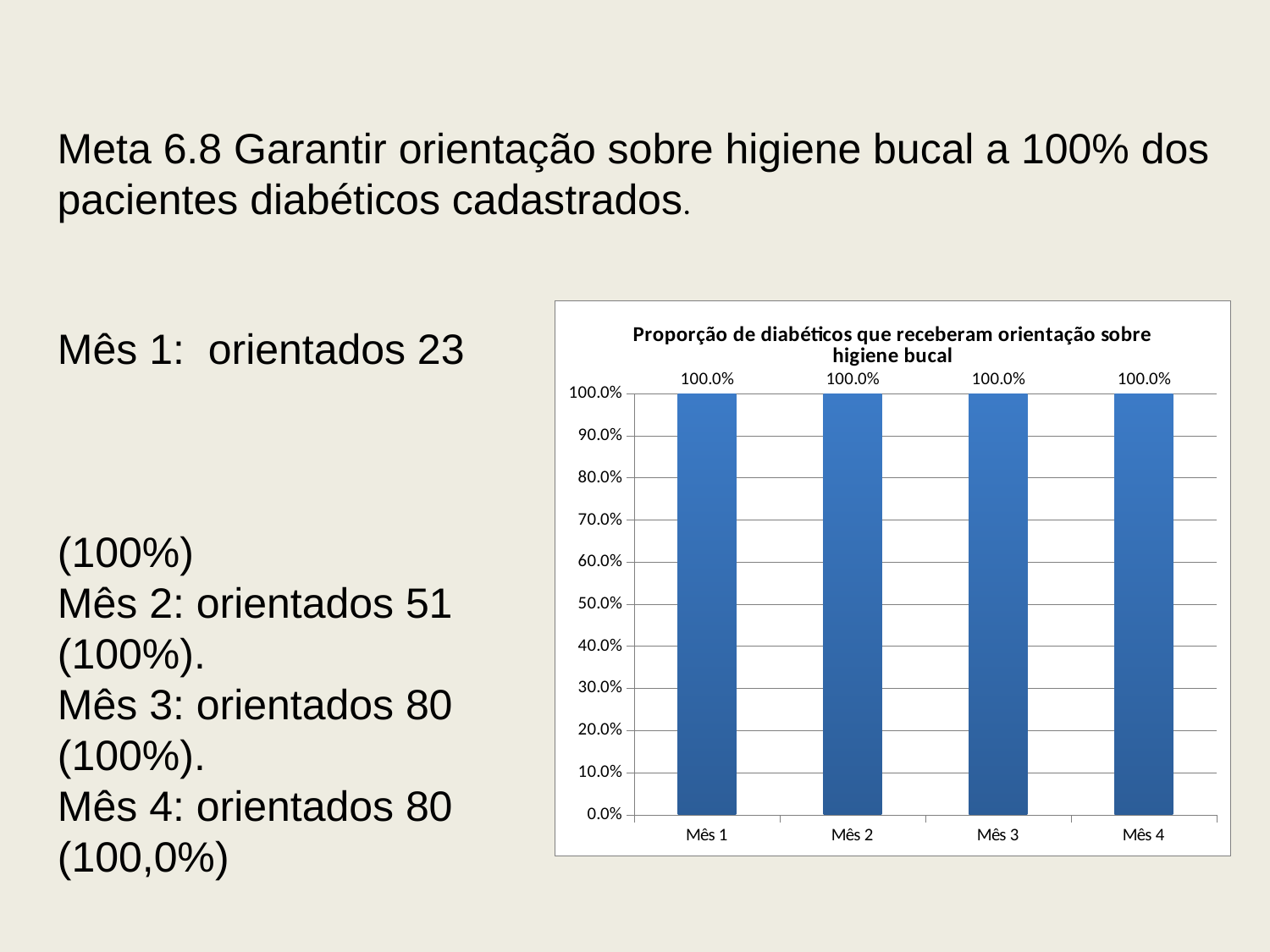
Is the value for Mês 2 greater or less than 50.0%? greater What is the value for Mês 3? 100.0% What kind of chart is shown on the slide? bar chart Do the values rise, fall or stay the same from Mês 1 to Mês 4? stay the same What is the title of the chart? Proporção de diabéticos que receberam orientação sobre higiene bucal What is the value for Mês 2? 100.0% What is the value for Mês 4? 100.0% What is the difference between the values for Mês 1 and Mês 4? 0.0% What is the highest value shown on the y axis of the chart? 100.0% How many categories are shown on the x axis of the chart? 4 What is the value for Mês 1? 100.0%